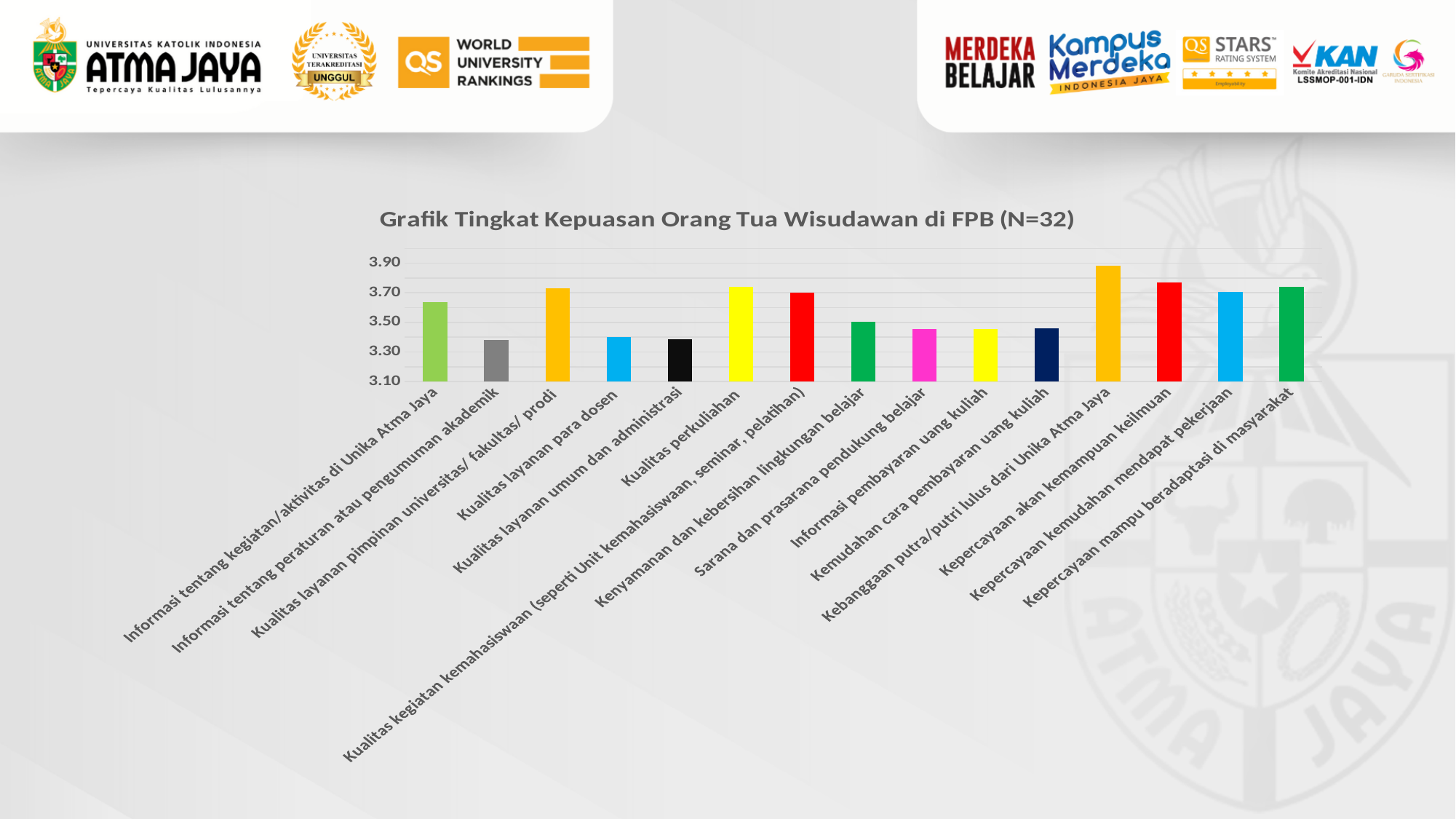
What is the lowest value shown on the vertical axis of the chart? 3.10 Which is larger: the value for Kualitas perkuliahan or the value for Kualitas layanan para dosen? Kualitas perkuliahan Is the value for Kebanggaan putra/putri lulus dari Unika Atma Jaya greater or less than 3.70? greater Is the value for Kualitas layanan pimpinan universitas/ fakultas/ prodi greater or less than 3.50? greater What type of chart is shown on the slide? Bar chart How many categories are plotted in the chart? 15 Which category has the highest value in the chart? Kebanggaan putra/putri lulus dari Unika Atma Jaya Is the value for Kualitas layanan para dosen greater or less than 3.50? less Which is larger: the value for Informasi tentang kegiatan/aktivitas di Unika Atma Jaya or the value for Kualitas layanan umum dan administrasi? Informasi tentang kegiatan/aktivitas di Unika Atma Jaya What is the title of the chart? Grafik Tingkat Kepuasan Orang Tua Wisudawan di FPB (N=32)